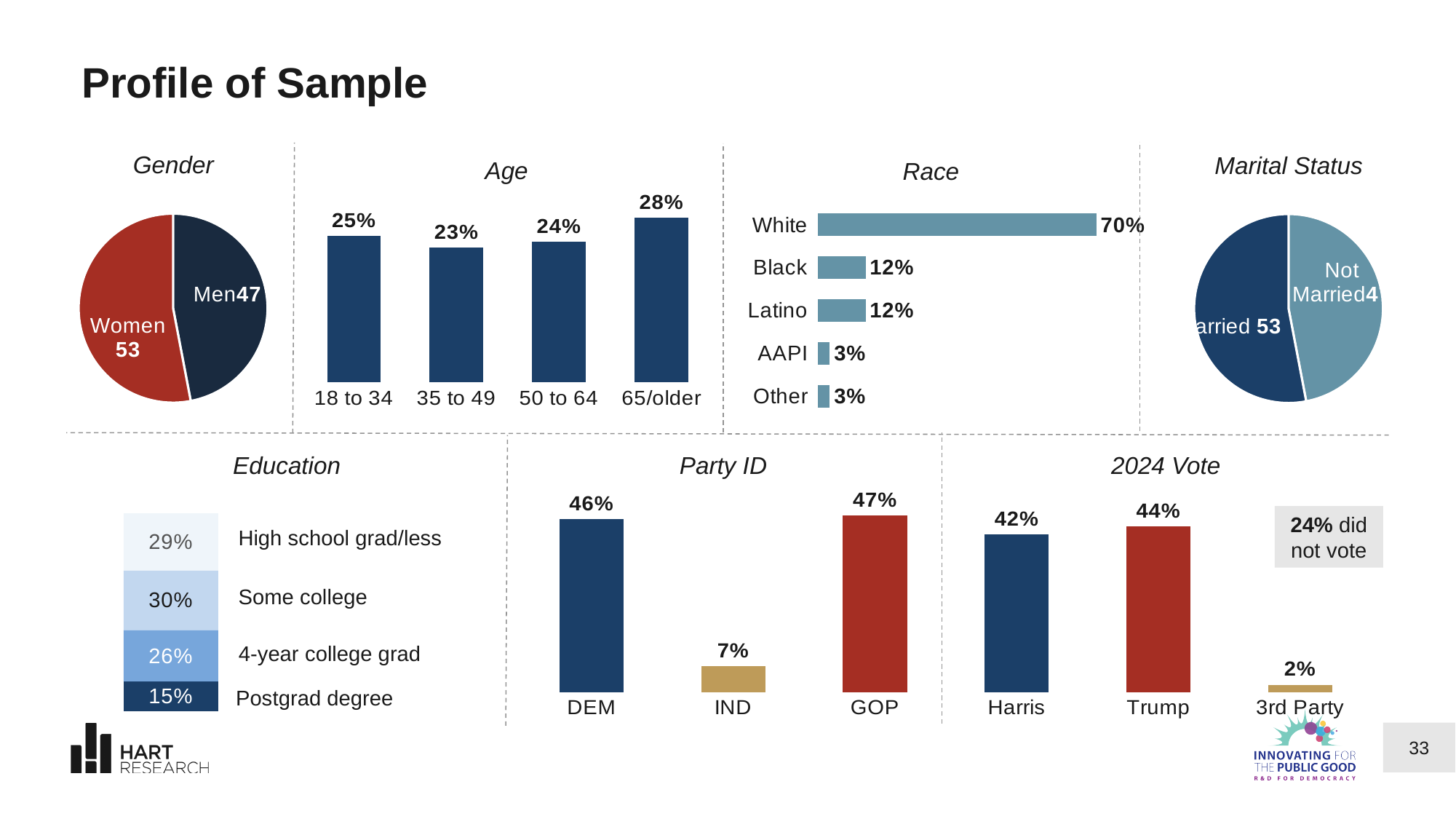
In the Race chart, what is the difference between the White share and the Black share? 58% What kind of chart is used for the Race section? Bar chart In the Age chart, which age group has the lowest share? 35 to 49 How many race categories are shown in the Race chart? 5 In the 2024 Vote chart, what is the difference between the Trump and Harris values? 2% In the Party ID chart, what is the value for IND? 7% In the Age chart, what percentage of the sample is 65/older? 28% In the 2024 Vote chart, which is larger, the value for Harris or the value for Trump? Trump In the Race chart, what percentage of the sample is White? 70% In the Education chart, what percentage of the sample has a postgrad degree? 15% In the Party ID chart, which party has the highest share? GOP In the Gender pie chart, what is the value for Women? 53